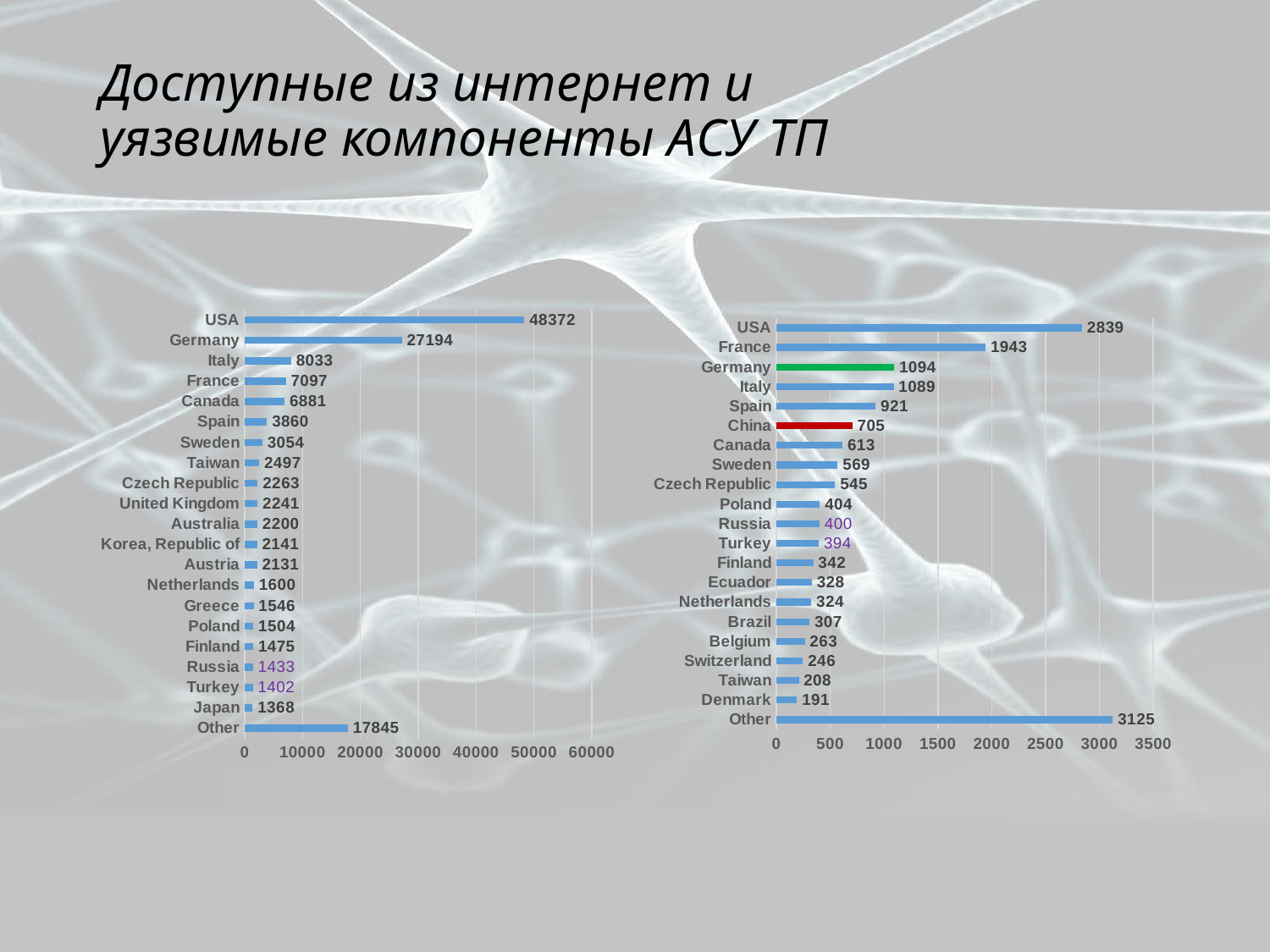
In the right chart, which is larger, the value for Germany or the value for Italy? Germany In the right chart, which bar is coloured green? Germany In the right chart, which category has the lowest value? Denmark In the left chart, which category has the lowest value? Japan In the left chart, how many categories are shown? 21 In the right chart, what is the difference between the values for USA and France? 896 In the left chart, which category has the highest value? USA In the left chart, what is the value for Germany? 27194 In the right chart, what is the value for Other? 3125 What kind of chart is the right chart? Bar chart In the left chart, what is the difference between the values for Italy and France? 936 In the right chart, what is the value for China? 705